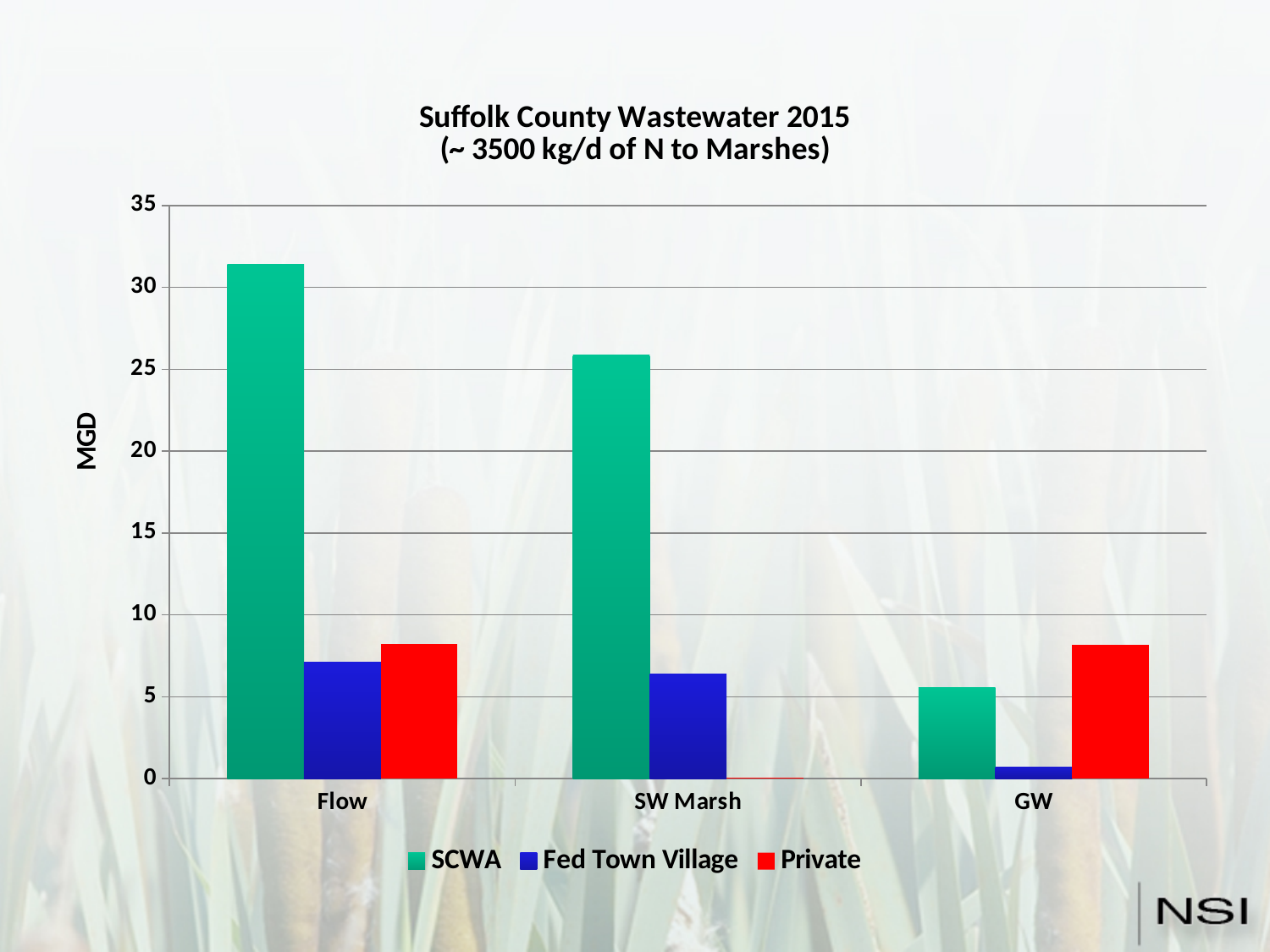
Which is larger for GW, the SCWA value or the Private value? Private Is the Fed Town Village value for GW greater or less than 5? less Which category has the lowest Fed Town Village value? GW Is the SCWA value for Flow greater or less than 30? greater How many categories are shown on the x axis? 3 What type of chart is shown on the slide? bar chart Which is larger for Flow, the SCWA value or the Fed Town Village value? SCWA Which category has the lowest SCWA value? GW Is the SCWA value for SW Marsh greater or less than 25? greater Which category has the highest SCWA value? Flow What is the label on the y axis? MGD How many series does the legend list? 3